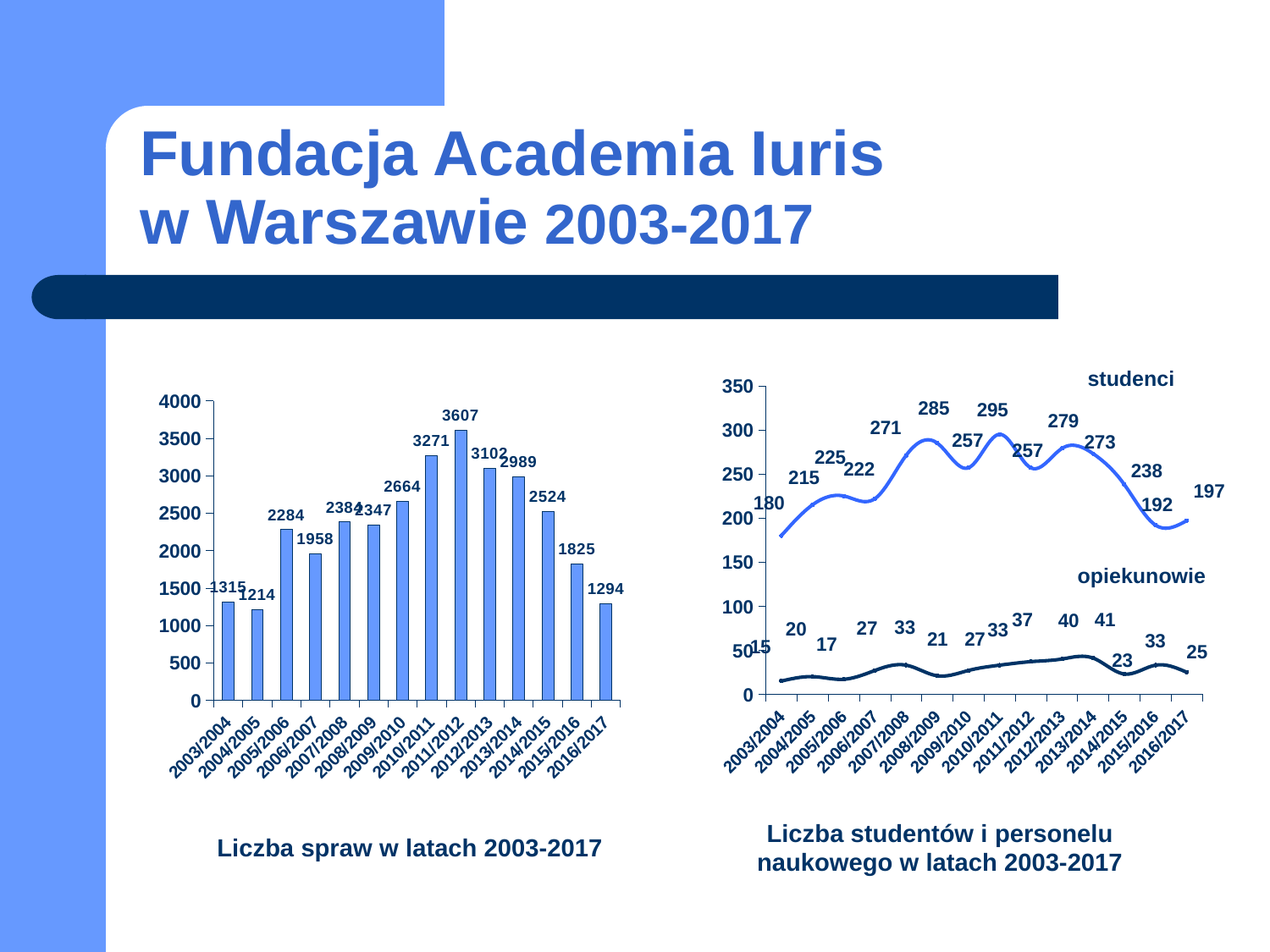
In the chart 'Liczba studentów i personelu naukowego w latach 2003-2017', is the value of studenci for 2016/2017 larger than the value for 2015/2016? Yes In the chart 'Liczba spraw w latach 2003-2017', what is the value for 2011/2012? 3607 In the chart 'Liczba studentów i personelu naukowego w latach 2003-2017', what is the value of opiekunowie for 2013/2014? 41 In the chart 'Liczba spraw w latach 2003-2017', which year has the lowest value? 2004/2005 In the chart 'Liczba spraw w latach 2003-2017', how many years are shown on the x axis? 14 In the chart 'Liczba studentów i personelu naukowego w latach 2003-2017', what is the value of studenci for 2010/2011? 295 In the chart 'Liczba studentów i personelu naukowego w latach 2003-2017', what is the difference between studenci and opiekunowie in 2003/2004? 165 In the chart 'Liczba studentów i personelu naukowego w latach 2003-2017', which year has the lowest value for studenci? 2003/2004 In the chart 'Liczba spraw w latach 2003-2017', what is the difference between the values for 2010/2011 and 2009/2010? 607 What kind of chart is 'Liczba studentów i personelu naukowego w latach 2003-2017'? line chart In the chart 'Liczba spraw w latach 2003-2017', which year has the highest value? 2011/2012 What kind of chart is 'Liczba spraw w latach 2003-2017'? bar chart